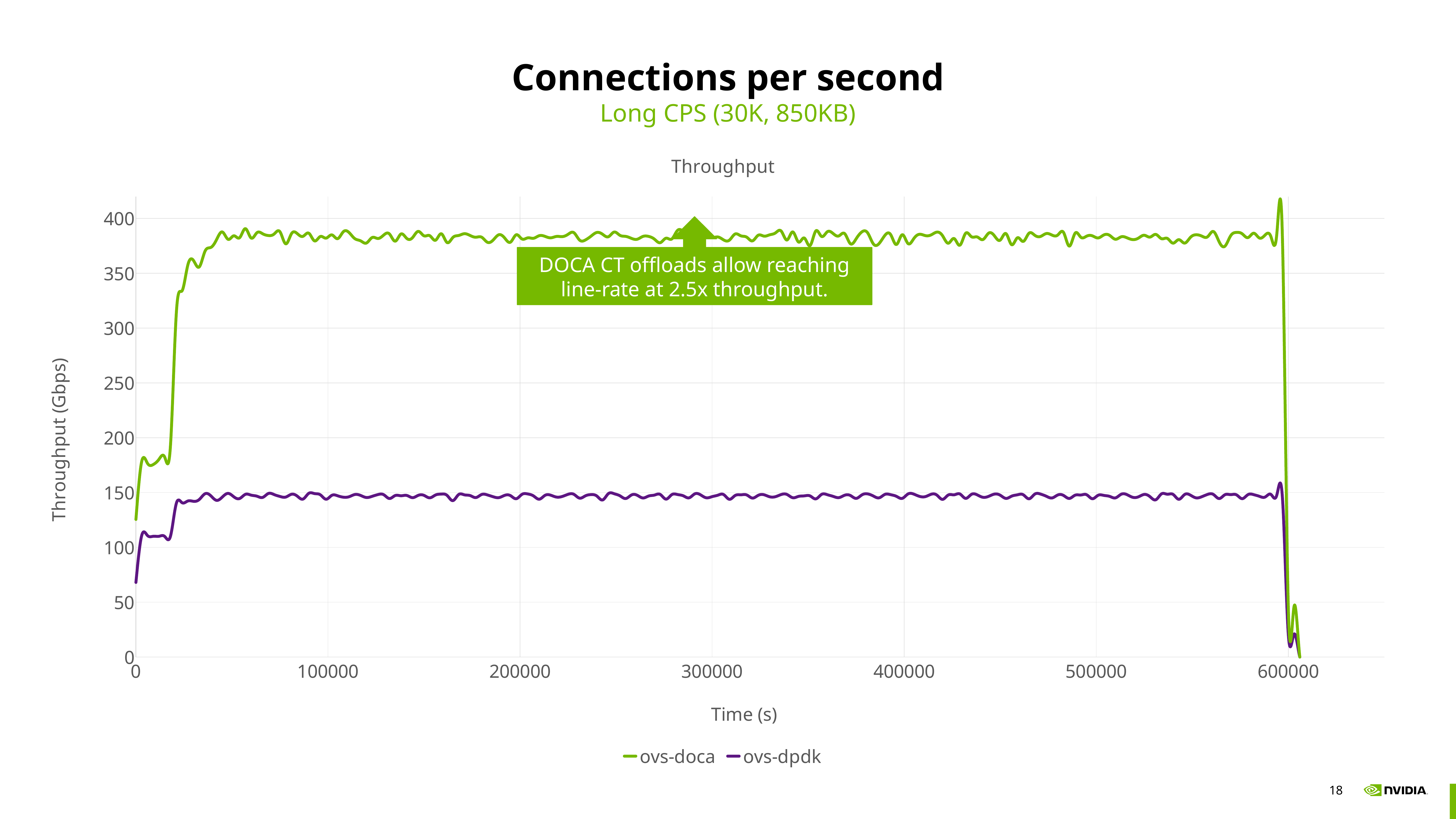
What kind of chart is shown on the slide? line chart Is the steady-state throughput of ovs-doca at 300000 s greater or less than 350? greater What are the names of the two series in the legend? ovs-doca and ovs-dpdk How many series does the legend list? 2 What is the label of the y axis? Throughput (Gbps) Is the throughput of ovs-doca at 500000 s greater or less than 400? less Between 100000 s and 500000 s, does the ovs-dpdk throughput rise, fall, or stay roughly flat? stay roughly flat Is the steady-state throughput of ovs-dpdk at 300000 s greater or less than 200? less What is the title of the chart? Throughput Which series has the higher throughput during the steady-state portion of the test, ovs-doca or ovs-dpdk? ovs-doca